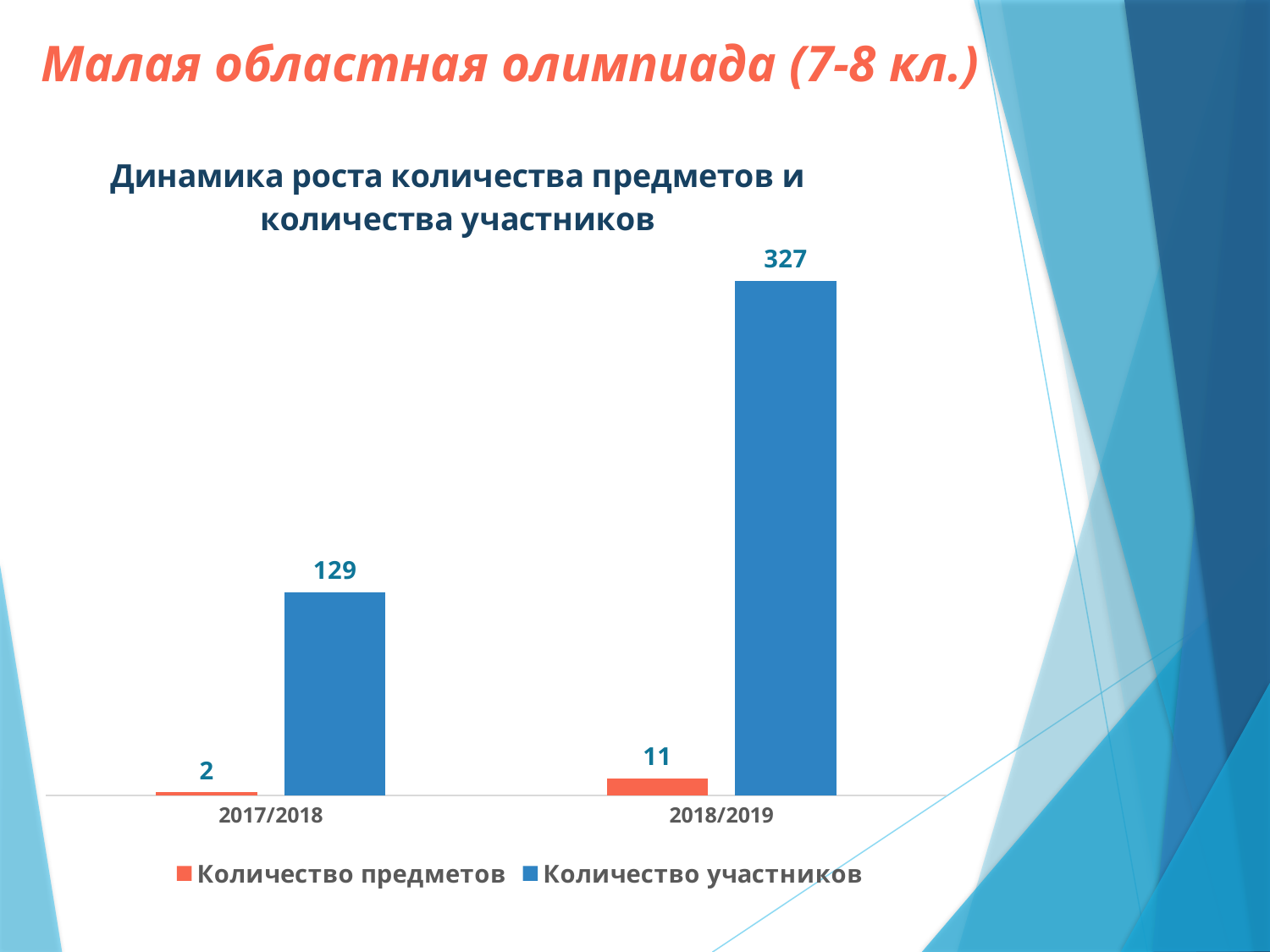
Which is larger: the number of participants in 2017/2018 or in 2018/2019? 2018/2019 Which year has the lower number of subjects? 2017/2018 What is the difference in the number of subjects between 2018/2019 and 2017/2018? 9 What is the number of subjects (Количество предметов) in 2017/2018? 2 What kind of chart is shown on the slide? Bar chart How many series does the legend list? 2 How many categories (years) are shown on the x axis? 2 By how much did the number of participants increase from 2017/2018 to 2018/2019? 198 Which year has the higher number of participants? 2018/2019 What is the number of participants (Количество участников) in 2018/2019? 327 What is the number of subjects (Количество предметов) in 2018/2019? 11 What is the number of participants (Количество участников) in 2017/2018? 129